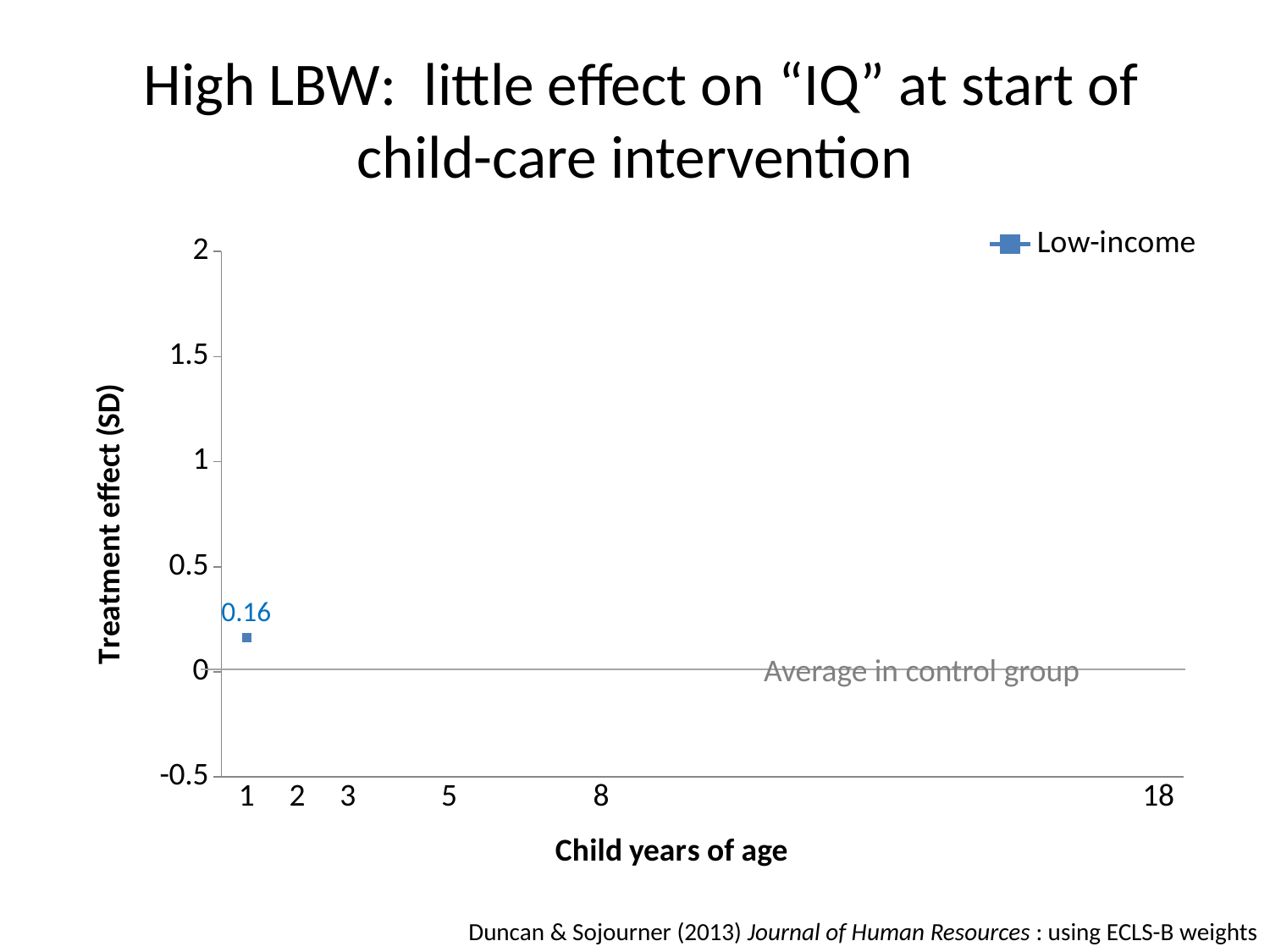
What series name is shown in the legend? Low-income What is the treatment effect for the Low-income series at child age 1? 0.16 How many tick labels are shown on the x axis (Child years of age)? 6 How many series does the legend list? 1 How many data points are plotted for the Low-income series? 1 Is the value for the Low-income series at age 1 greater or less than 0? greater What is the lowest value shown on the y axis? -0.5 What is the label of the horizontal reference line at 0? Average in control group Is the value for the Low-income series at age 1 greater or less than 0.5? less What is the highest value shown on the y axis? 2